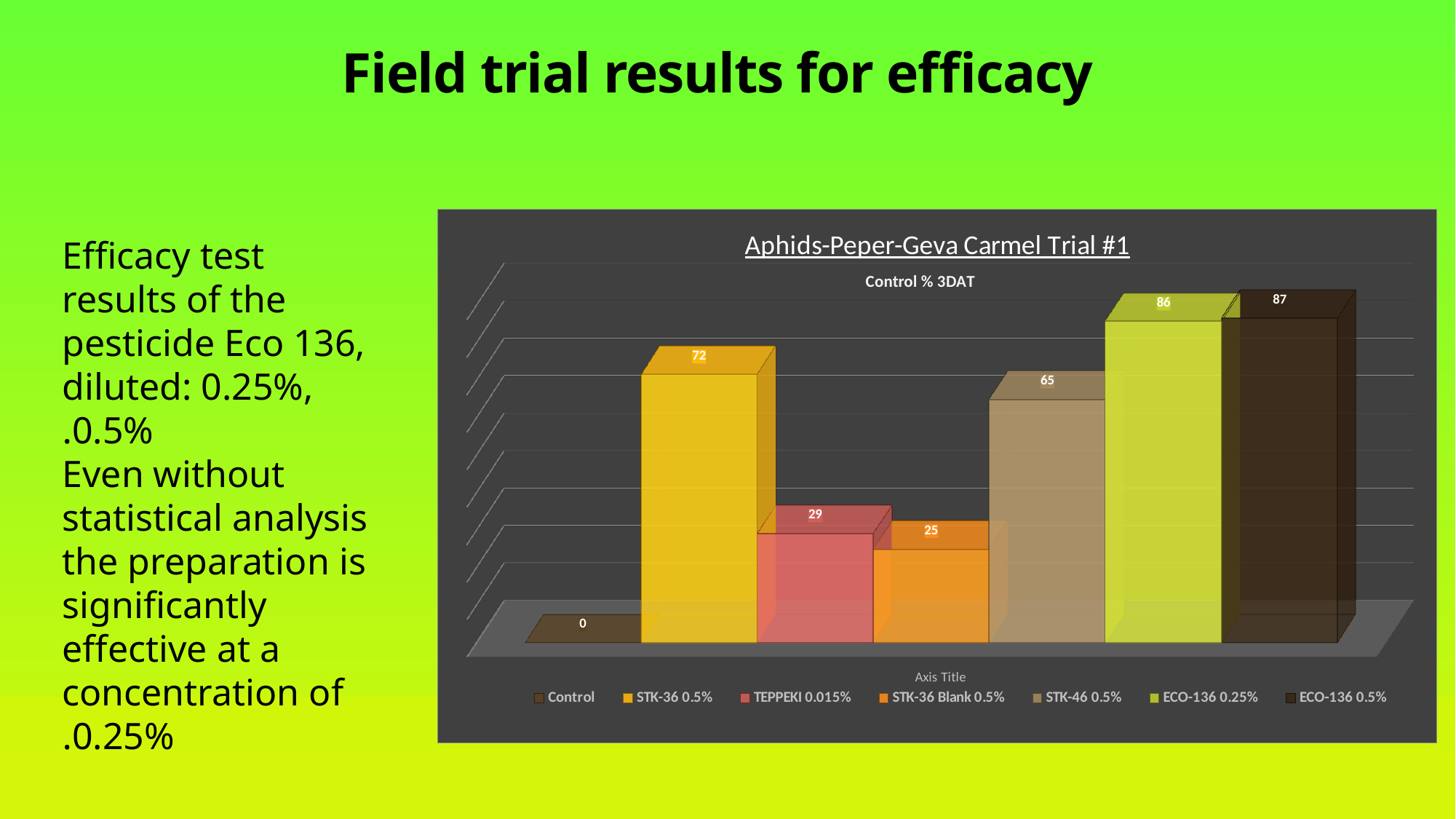
What is the value for TEPPEKI 0.015% in the Control % 3DAT chart? 29 What is the value for STK-36 0.5% in the Control % 3DAT chart? 72 How many series does the legend of the Control % 3DAT chart list? 7 What is the value for the Control series in the Control % 3DAT chart? 0 What kind of chart is the Control % 3DAT chart? Bar chart What is the value for ECO-136 0.25% in the Control % 3DAT chart? 86 Which series has the lowest value in the Control % 3DAT chart? Control What is the value for STK-46 0.5% in the Control % 3DAT chart? 65 What is the difference between the values for STK-36 0.5% and STK-36 Blank 0.5% in the Control % 3DAT chart? 47 Which series has the highest value in the Control % 3DAT chart? ECO-136 0.5% What is the trial name shown above the Control % 3DAT chart? Aphids-Peper-Geva Carmel Trial #1 Which is larger in the Control % 3DAT chart, the value for TEPPEKI 0.015% or the value for STK-46 0.5%? STK-46 0.5%